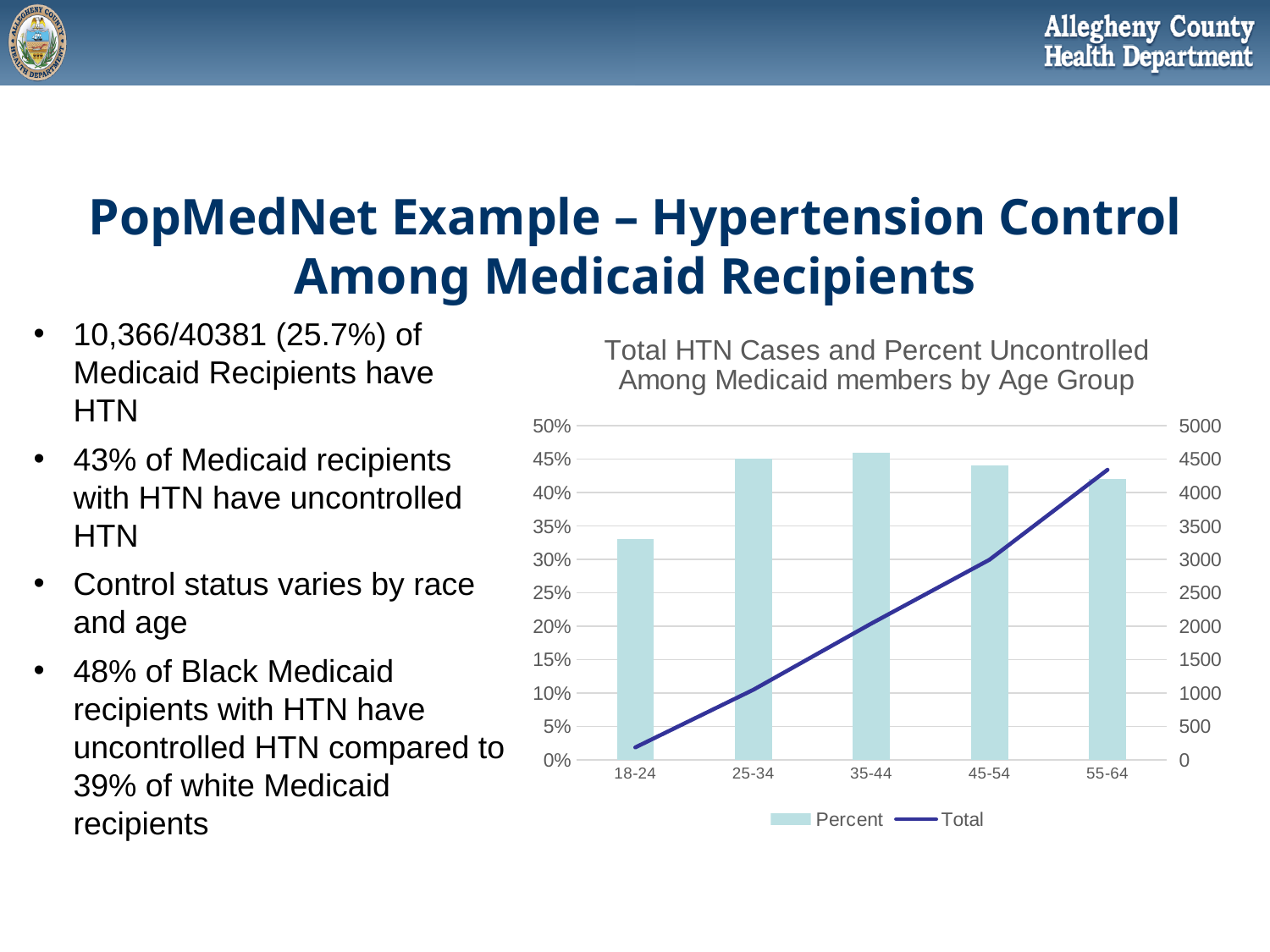
Which age group has the lowest Percent bar? 18-24 Which age group has the highest Total value on the line? 55-64 Which age group has the lowest Total value on the line? 18-24 What is the title of the chart? Total HTN Cases and Percent Uncontrolled Among Medicaid members by Age Group How many series does the chart's legend list? 2 Is the Percent value for 25-34 greater or less than 40%? greater How many age groups are shown on the x axis of the chart? 5 Is the Total value for 55-64 greater or less than 4000? greater What kind of chart is shown on the slide? A combination bar and line chart Does the Total line rise or fall as age group increases along the x axis? rises Is the Total value for 45-54 greater or less than 3500? less